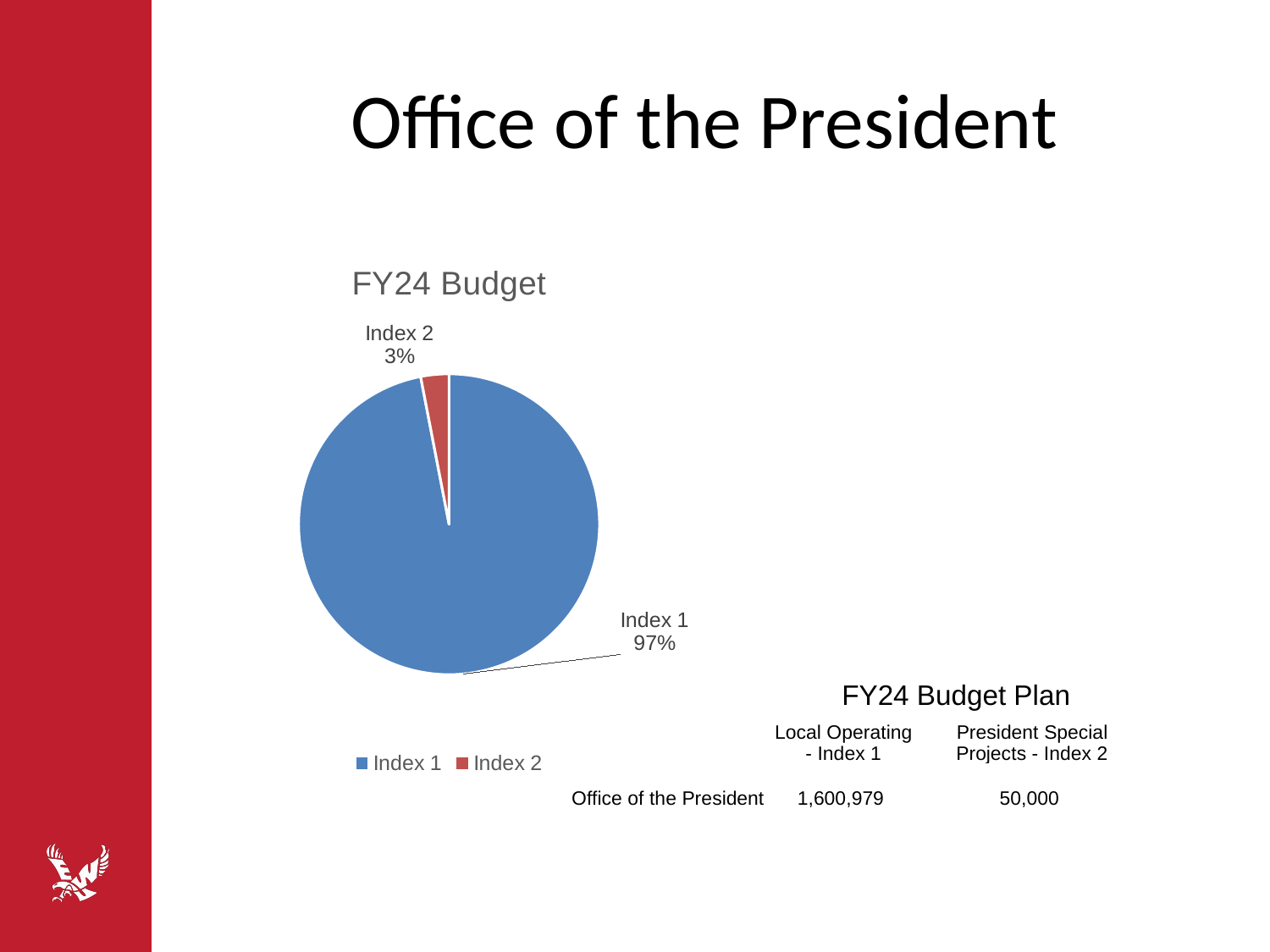
What kind of chart is shown on the slide? pie chart Which slice of the pie is the largest? Index 1 What share of the pie does Index 1 represent? 97% Which is larger, the share for Index 1 or the share for Index 2? Index 1 What is the chart's title? FY24 Budget What colour is the Index 2 slice? red Which slice of the pie is the smallest? Index 2 How many slices does the pie chart have? 2 What share of the pie does Index 2 represent? 3% How many entries does the legend list? 2 What is the difference in percentage points between the Index 1 share and the Index 2 share? 94